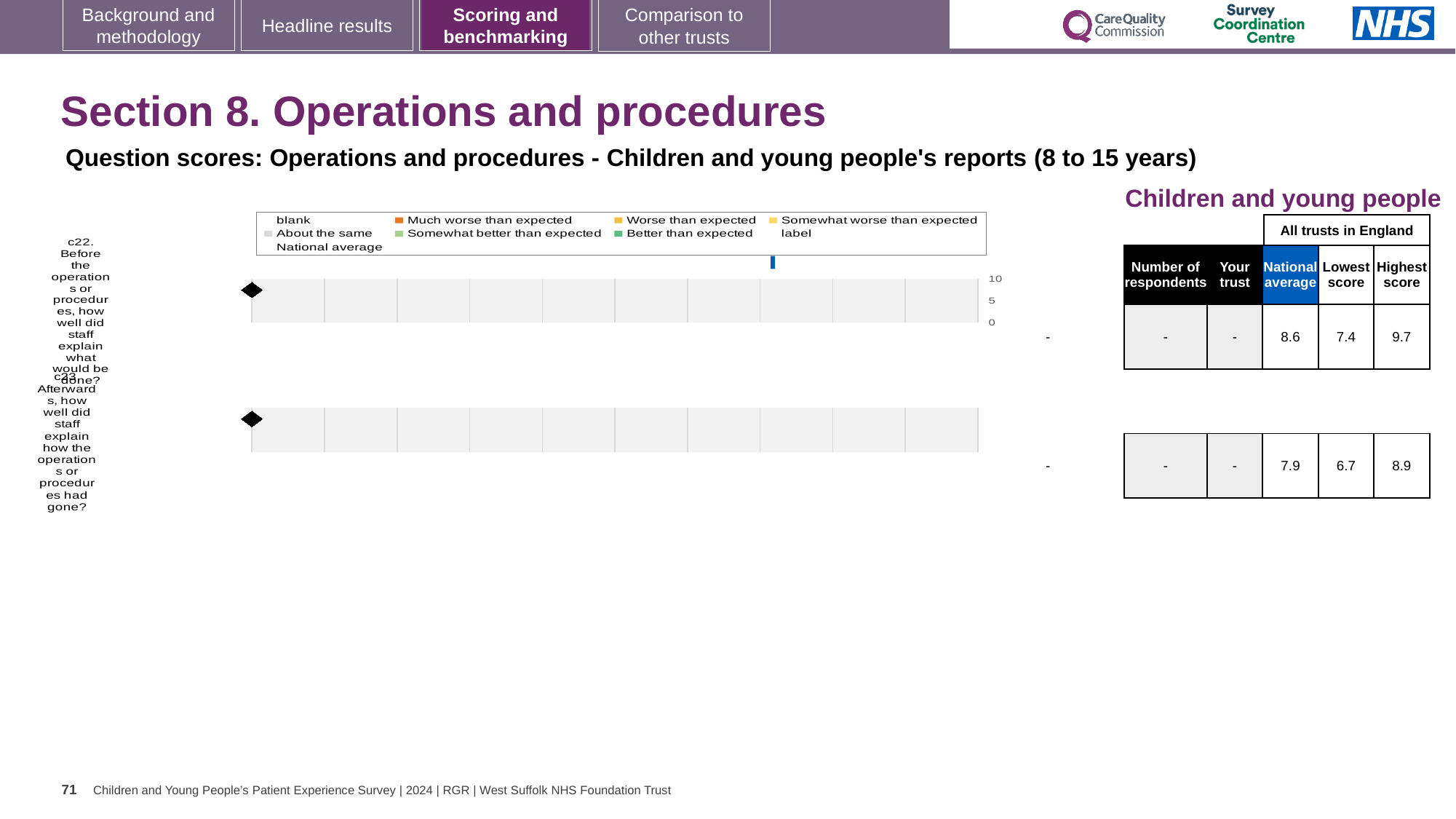
In the table next to the chart, what is the difference between the highest score and the lowest score for c23? 2.2 What kind of chart is used to show the question scores? bar chart In the table next to the chart, what is the lowest score across all trusts in England for c22? 7.4 In the table next to the chart, what is the difference between the highest score and the lowest score for c22? 2.3 In the table next to the chart, what is the national average score for c22 (Before the operations or procedures, how well did staff explain what would be done?)? 8.6 Which legend entry is shown with an orange marker? Much worse than expected What value is shown for 'Your trust' for c22 in the table? - In the table next to the chart, what is the highest score across all trusts in England for c23 (Afterwards, how well did staff explain how the operations or procedures had gone?)? 8.9 How many survey questions (categories) are plotted on the chart? 2 What is the highest value shown on the chart's score axis? 10 Which question has the higher national average in the table, c22 or c23? c22 In the table next to the chart, what is the national average score for c23? 7.9